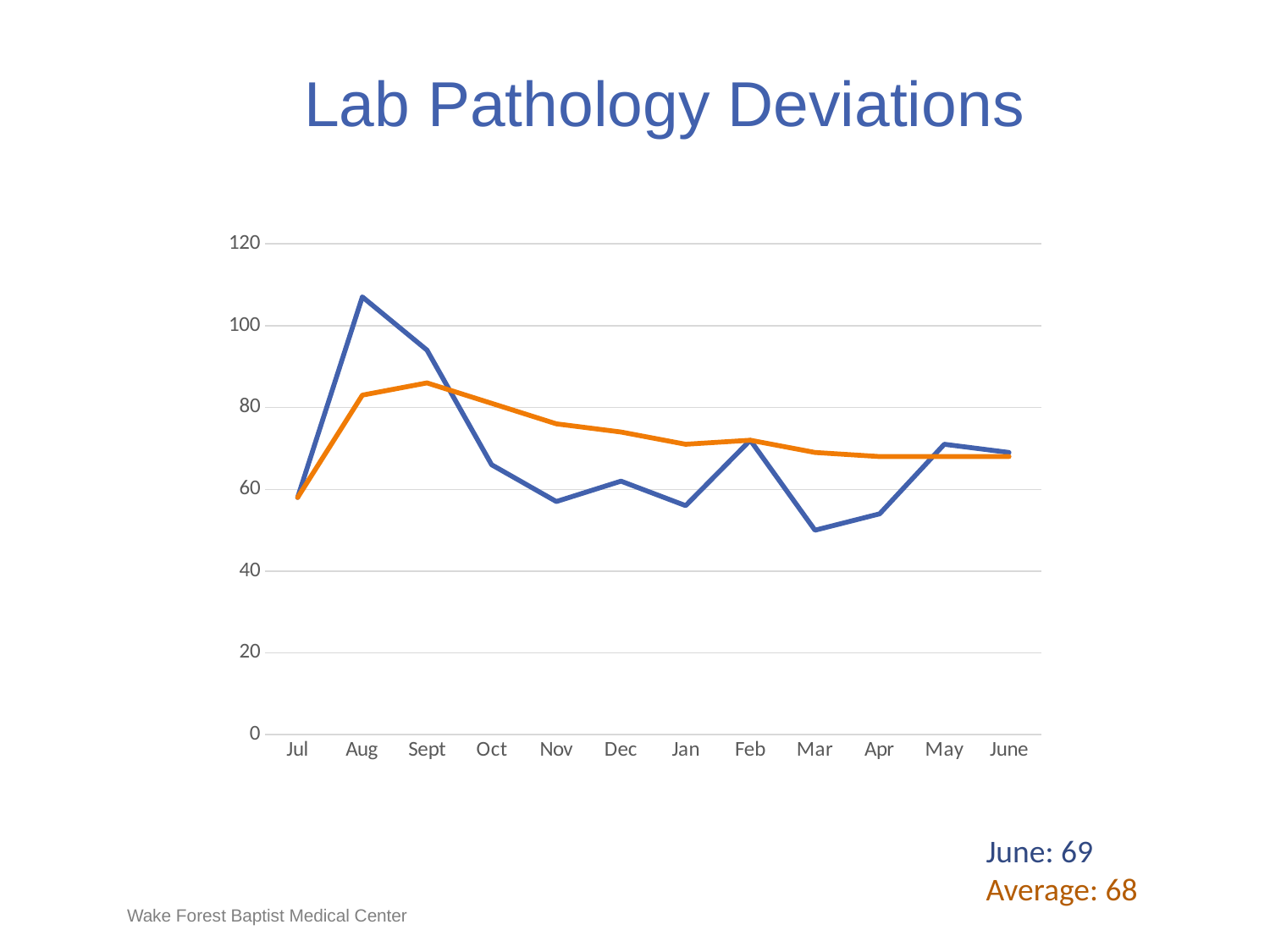
Is the blue line's value for Aug greater or less than 100? greater What is the difference between the June value (69) and the average (68)? 1 What is the title of the chart? Lab Pathology Deviations How many months are shown along the x axis? 12 Is the blue line's value for Mar greater or less than 60? less In which month does the blue line reach its highest value? Aug In which month does the blue line reach its lowest value? Mar Which month has the larger value on the blue line, Feb or Mar? Feb What is the value for June on the blue line? 69 How many lines are plotted on the chart? 2 What is the average value stated on the slide? 68 What kind of chart is shown on the slide? line chart